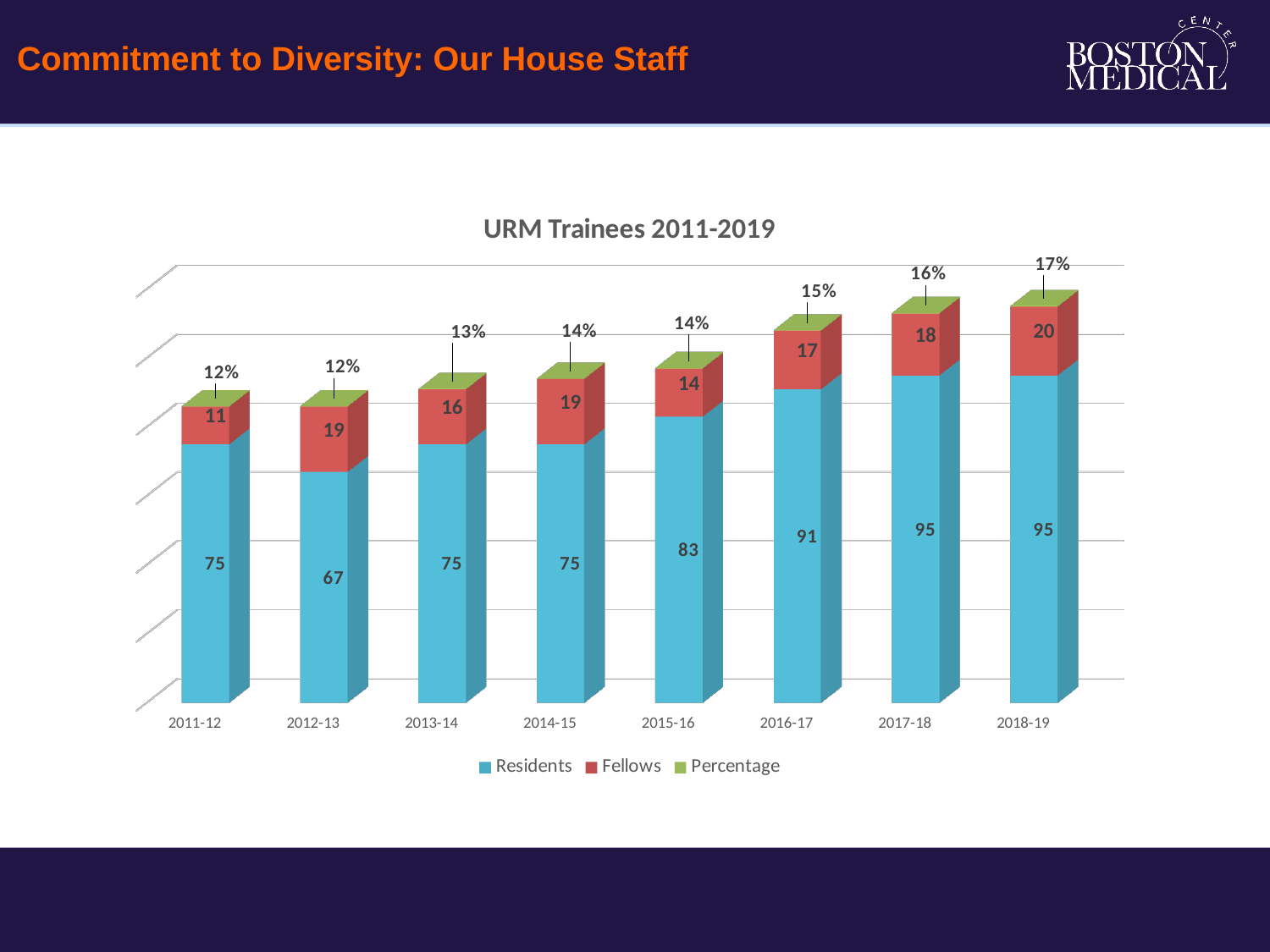
How many years are shown on the x axis? 8 Which is larger, the Fellows value for 2012-13 or the Fellows value for 2015-16? 2012-13 What is the Residents value for 2012-13? 67 What is the difference between the Residents values for 2018-19 and 2011-12? 20 Which year has the lowest Fellows value? 2011-12 What kind of chart is shown? Stacked bar chart Which year has the lowest Residents value? 2012-13 Which year has the highest Fellows value? 2018-19 What is the Percentage value for 2014-15? 14% How many series does the legend list? 3 What is the Fellows value for 2016-17? 17 Does the Percentage value rise or fall from 2011-12 to 2018-19? Rise